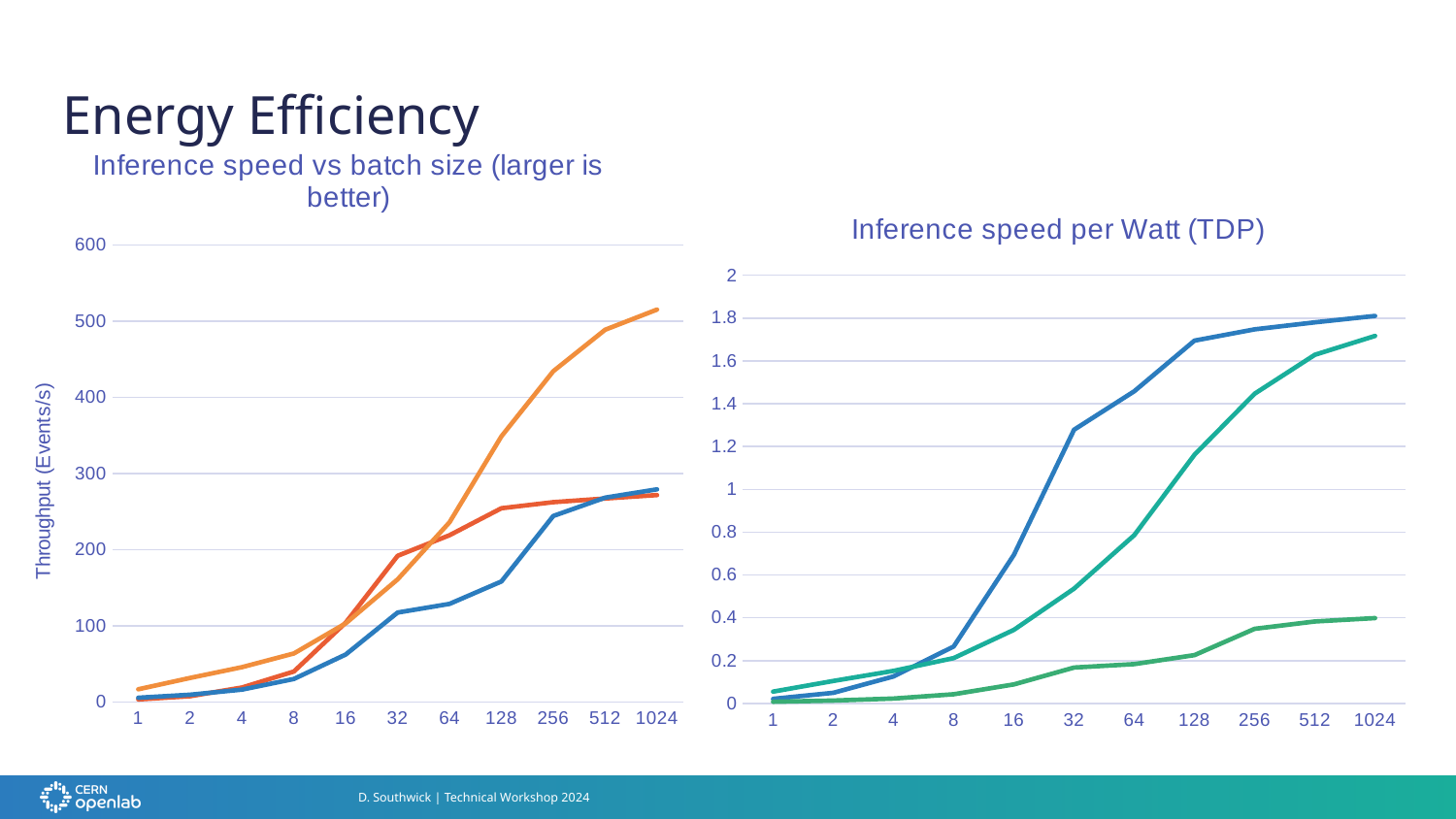
In the right chart 'Inference speed per Watt (TDP)', is the value of the highest line at batch size 1024 greater or less than 1.6? greater What is the y-axis label of the left chart 'Inference speed vs batch size'? Throughput (Events/s) In the left chart 'Inference speed vs batch size', is the value of the orange line at batch size 1024 greater or less than 500? greater In the left chart 'Inference speed vs batch size', do the values of the orange line rise or fall as batch size increases? rise What kind of chart is the left chart titled 'Inference speed vs batch size (larger is better)'? line chart In the left chart 'Inference speed vs batch size', is the value of the blue line at batch size 1024 greater or less than 300? less In the left chart 'Inference speed vs batch size', which line has the highest value at batch size 1024? the orange line What is the title of the right chart on the slide? Inference speed per Watt (TDP) In the left chart 'Inference speed vs batch size', how many batch sizes are shown on the x axis? 11 In the left chart 'Inference speed vs batch size', how many lines are plotted? 3 What kind of chart is the right chart titled 'Inference speed per Watt (TDP)'? line chart